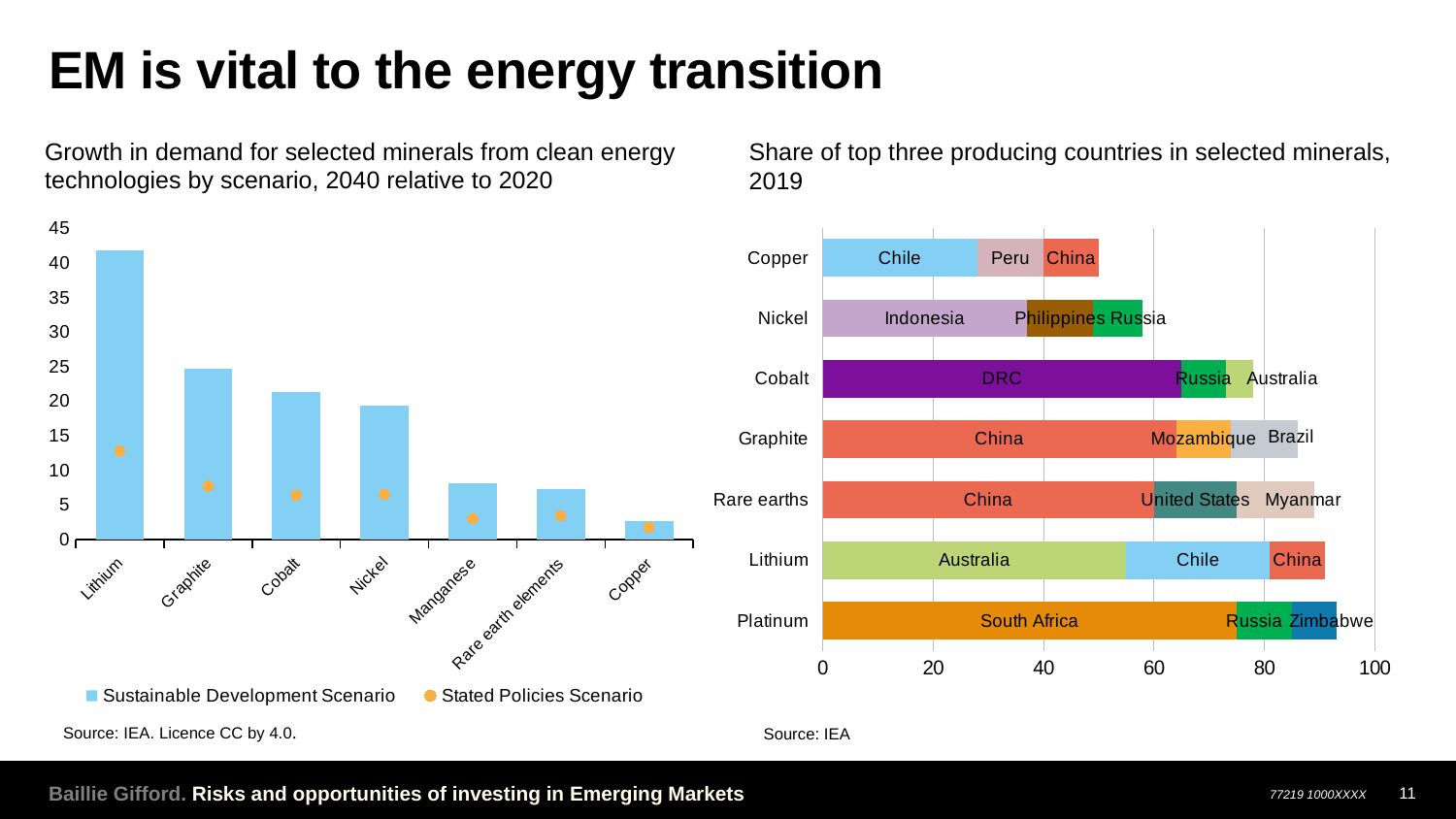
How many series does the legend of the left chart, 'Growth in demand for selected minerals', list? 2 What kind of chart is the left chart, 'Growth in demand for selected minerals from clean energy technologies by scenario, 2040 relative to 2020'? Combination chart with bars and dot markers In the left chart, 'Growth in demand for selected minerals', is the Sustainable Development Scenario value for Lithium greater or less than 35? greater How many minerals are listed in the right chart, 'Share of top three producing countries in selected minerals, 2019'? 7 In the left chart, 'Growth in demand for selected minerals', is the Sustainable Development Scenario value for Manganese greater or less than 10? less How many minerals are shown on the x axis of the left chart, 'Growth in demand for selected minerals'? 7 In the right chart, 'Share of top three producing countries in selected minerals, 2019', which country is the largest producer of Cobalt? DRC What kind of chart is the right chart, 'Share of top three producing countries in selected minerals, 2019'? Stacked bar chart In the right chart, 'Share of top three producing countries in selected minerals, 2019', is the combined share of the top three producers of Copper greater or less than 60? less In the left chart, 'Growth in demand for selected minerals', which mineral has the lowest Sustainable Development Scenario value? Copper In the left chart, 'Growth in demand for selected minerals', which is larger for Graphite: the Sustainable Development Scenario bar or the Stated Policies Scenario dot? Sustainable Development Scenario In the left chart, 'Growth in demand for selected minerals', which mineral has the highest Sustainable Development Scenario value? Lithium